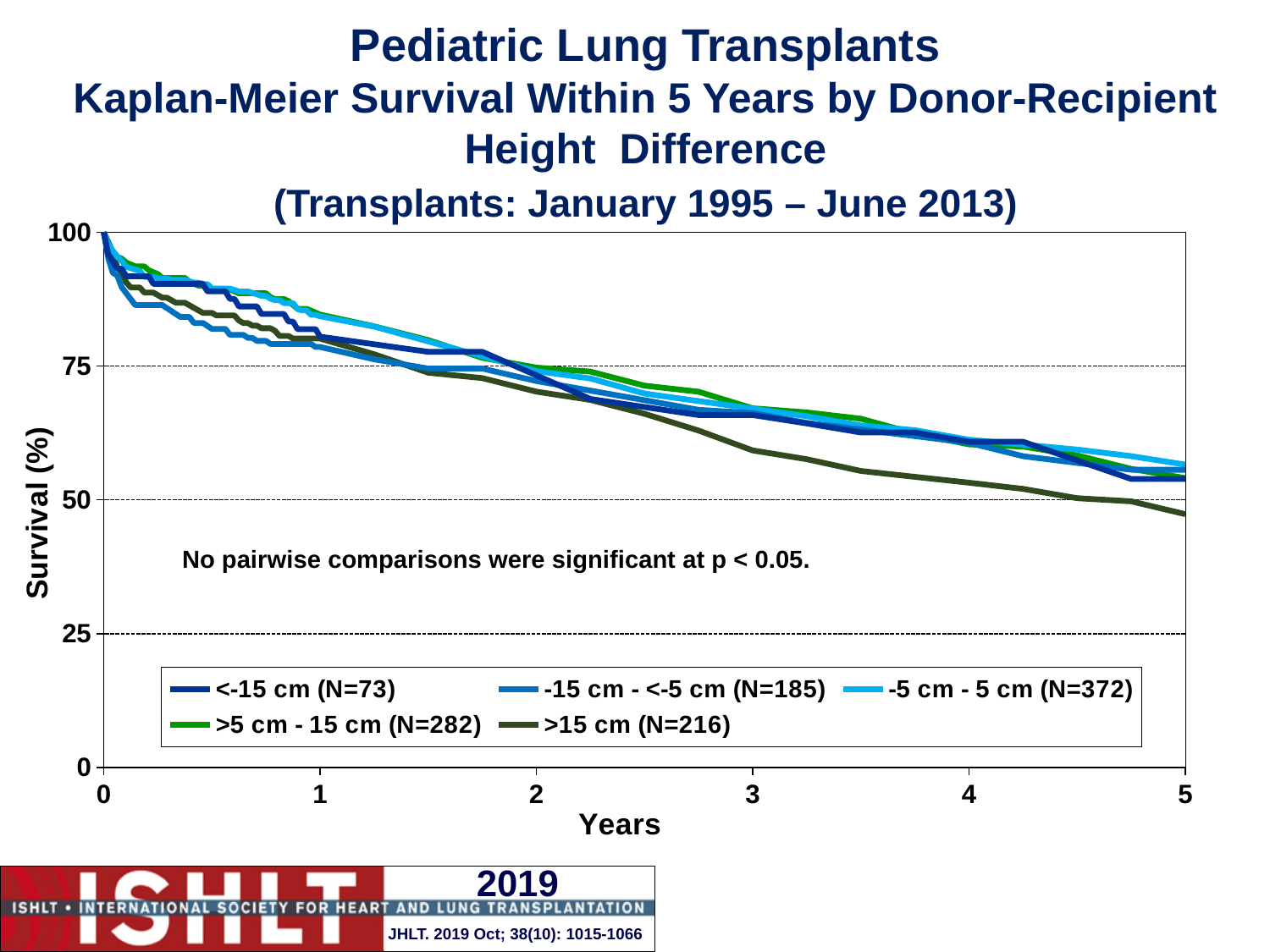
Which height-difference group has the lowest survival at 5 years? >15 cm (N=216) Is the survival for the >15 cm group at 5 years greater or less than 50? less At 5 years, which is higher: survival for the -5 cm - 5 cm group or the >15 cm group? -5 cm - 5 cm What is the N for the -5 cm - 5 cm group shown in the legend? 372 Is the survival for the -5 cm - 5 cm group at 5 years greater or less than 50? greater What kind of chart is shown on the slide? Line chart Do the survival curves rise or fall as years increase? Fall What transplant date range is given in the chart title? January 1995 – June 2013 Is the survival for the <-15 cm group at 3 years greater or less than 75? less What is the label of the y-axis? Survival (%) How many series does the legend list? 5